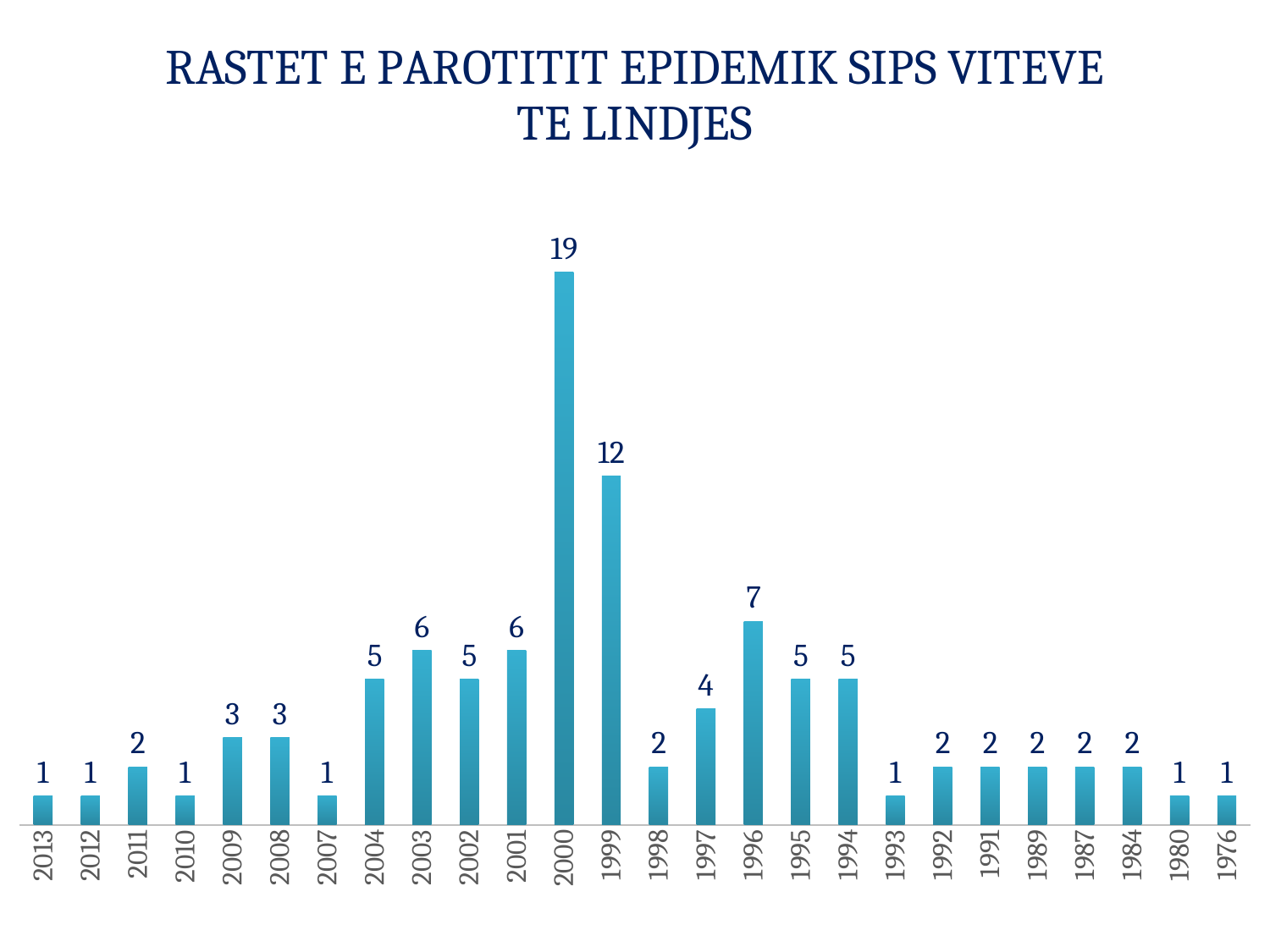
Which year has the highest value? 2000 What is the difference between the values for 2000 and 1999? 7 What kind of chart is this? bar chart Which is larger, the value for 2004 or the value for 2009? 2004 What is the value for 1999? 12 What is the value for 1996? 7 Which is larger, the value for 1997 or the value for 1998? 1997 What is the value for 2000? 19 What is the value for 2003? 6 What is the difference between the values for 1996 and 1997? 3 How many years are shown on the x axis? 26 What is the title of the chart? RASTET E PAROTITIT EPIDEMIK SIPS VITEVE TE LINDJES